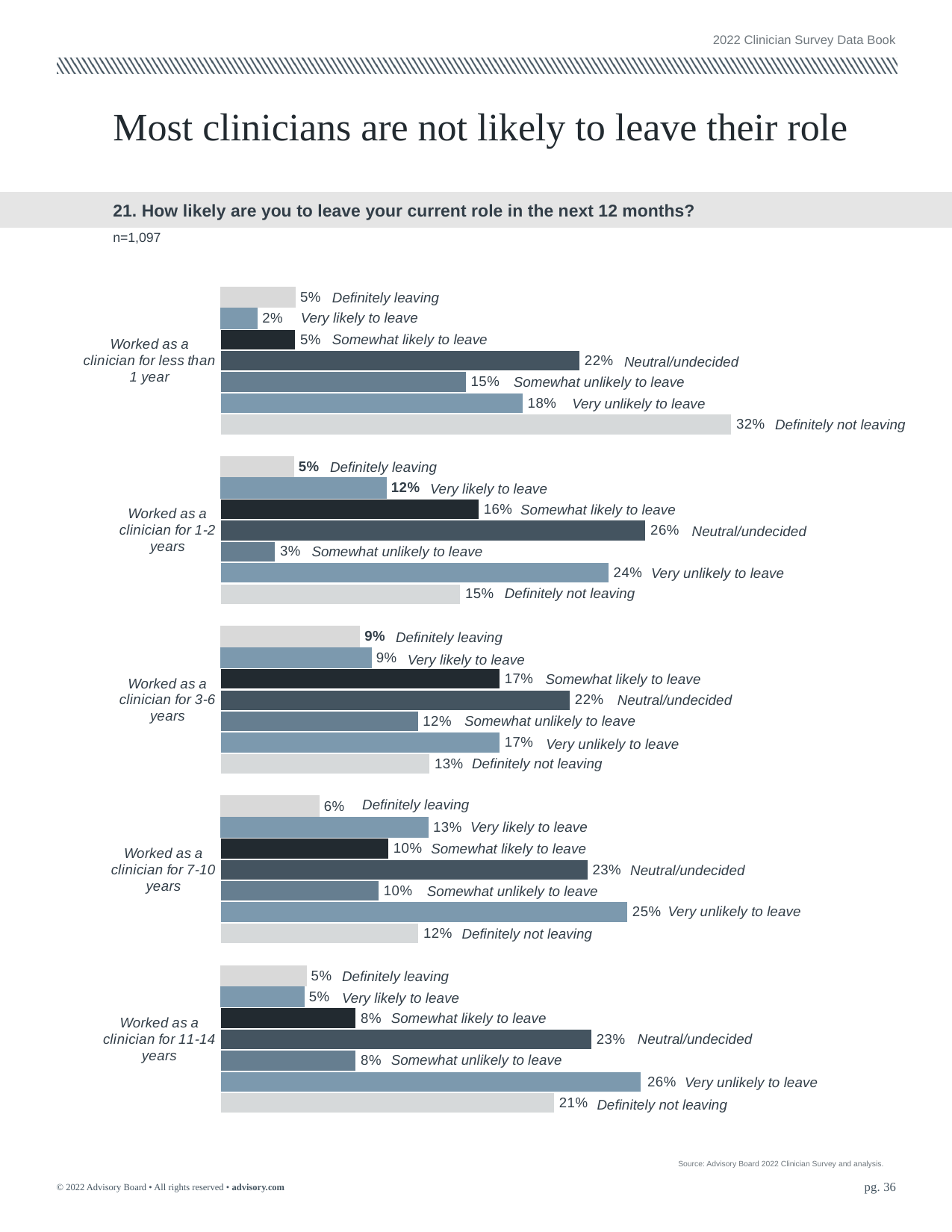
What percentage of clinicians who worked as a clinician for 1-2 years are neutral/undecided? 26% Among clinicians who worked as a clinician for 1-2 years, which response has the lowest percentage? Somewhat unlikely to leave What percentage of clinicians who worked as a clinician for less than 1 year are definitely not leaving? 32% Which is larger: the percentage of clinicians with 7-10 years of experience who are very likely to leave, or the percentage with 11-14 years who are very likely to leave? 7-10 years How many clinician tenure groups are shown in the chart? 5 What percentage of clinicians who worked as a clinician for 11-14 years are somewhat likely to leave? 8% Among clinicians who worked as a clinician for 3-6 years, which response has the highest percentage? Neutral/undecided Among clinicians who worked as a clinician for less than 1 year, which response has the lowest percentage? Very likely to leave What is the difference between the percentage of clinicians with less than 1 year of experience who are definitely not leaving and those with 1-2 years who are definitely not leaving? 17% What percentage of clinicians who worked as a clinician for 7-10 years are very unlikely to leave? 25% What type of chart is used on this slide? Bar chart What is the sample size (n) shown for the survey question on this slide? n=1,097